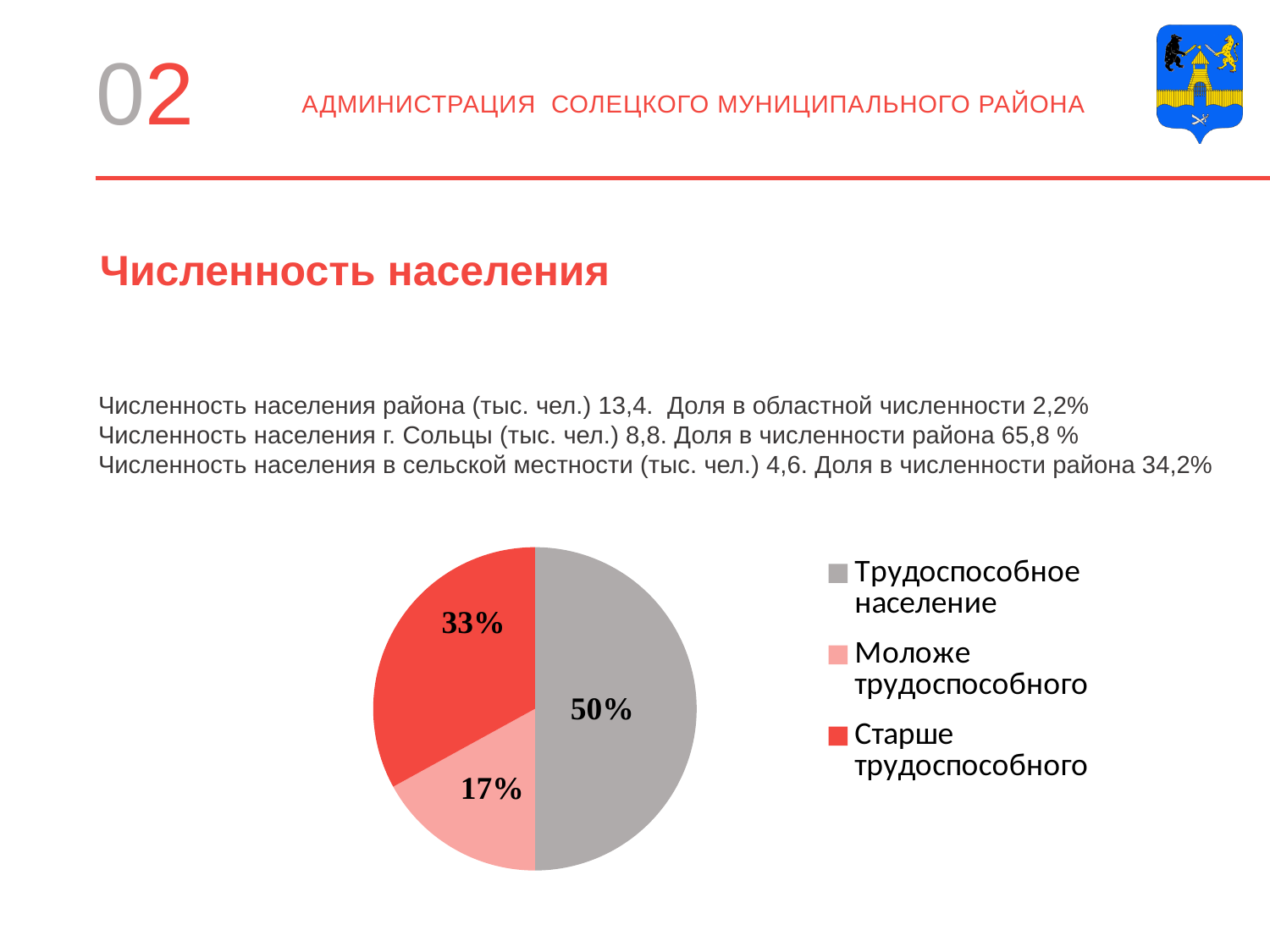
What share of the pie does "Старше трудоспособного" have? 33% Which category has the largest slice of the pie? Трудоспособное население What is the difference in percentage points between "Трудоспособное население" and "Старше трудоспособного"? 17% What share of the pie does "Моложе трудоспособного" have? 17% What kind of chart is shown on the slide? pie chart Which category has the smallest slice of the pie? Моложе трудоспособного How many slices does the pie chart have? 3 What is the difference in percentage points between "Старше трудоспособного" and "Моложе трудоспособного"? 16% Which is larger: the slice for "Старше трудоспособного" or the slice for "Моложе трудоспособного"? Старше трудоспособного What share of the pie does "Трудоспособное население" have? 50% What colour is the slice for "Трудоспособное население"? grey How many entries does the legend list? 3